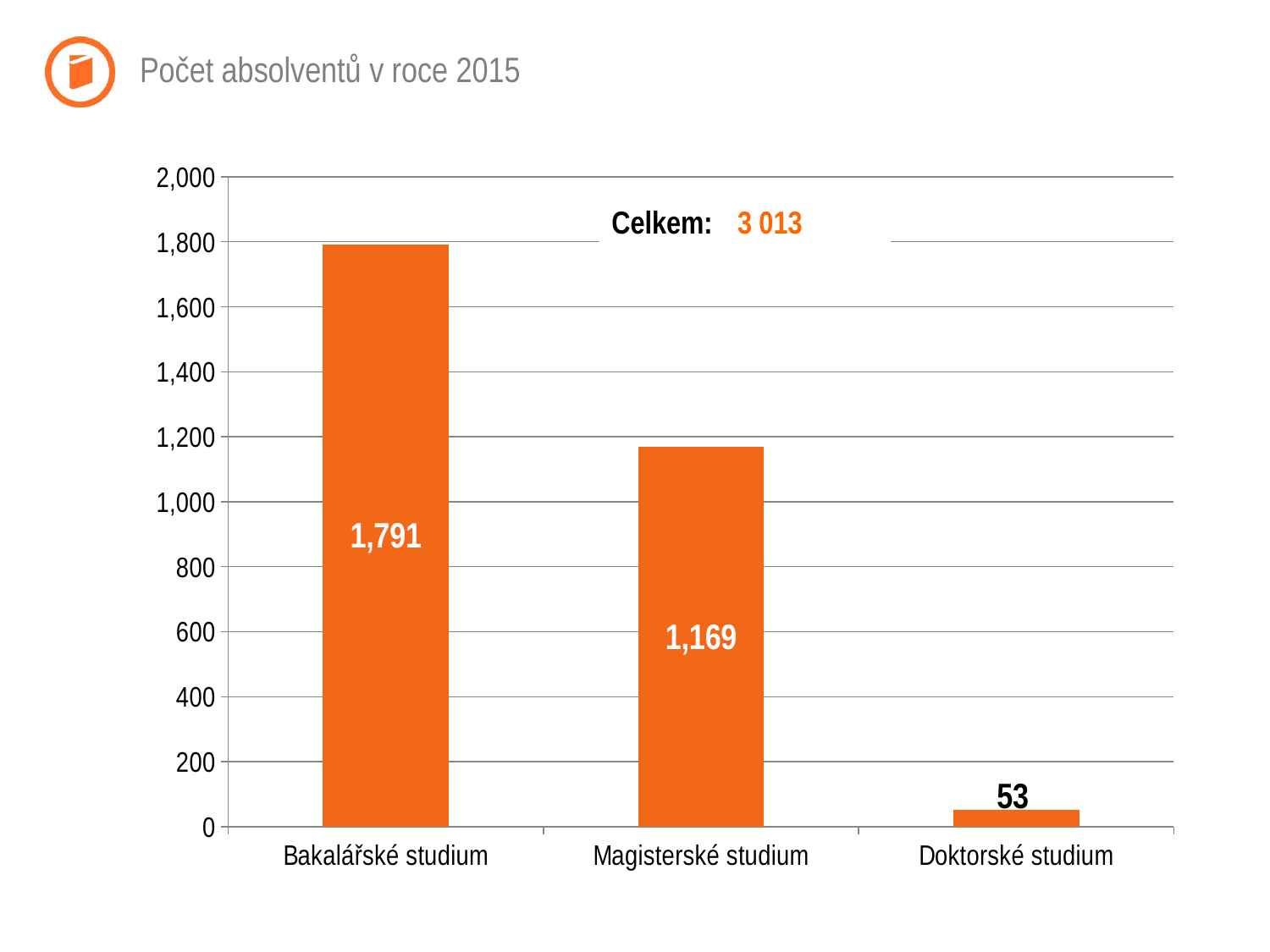
What total (Celkem) is printed on the chart? 3 013 How many categories are shown on the chart? 3 Which category has the highest value? Bakalářské studium What is the value for Magisterské studium? 1,169 What is the difference between the values for Magisterské studium and Doktorské studium? 1,116 Which is larger, the value for Magisterské studium or the value for Doktorské studium? Magisterské studium What kind of chart is shown on the slide? bar chart What is the value for Bakalářské studium? 1,791 What is the difference between the values for Bakalářské studium and Magisterské studium? 622 Is the value for Magisterské studium greater or less than 1,000? greater What is the value for Doktorské studium? 53 Which category has the lowest value? Doktorské studium